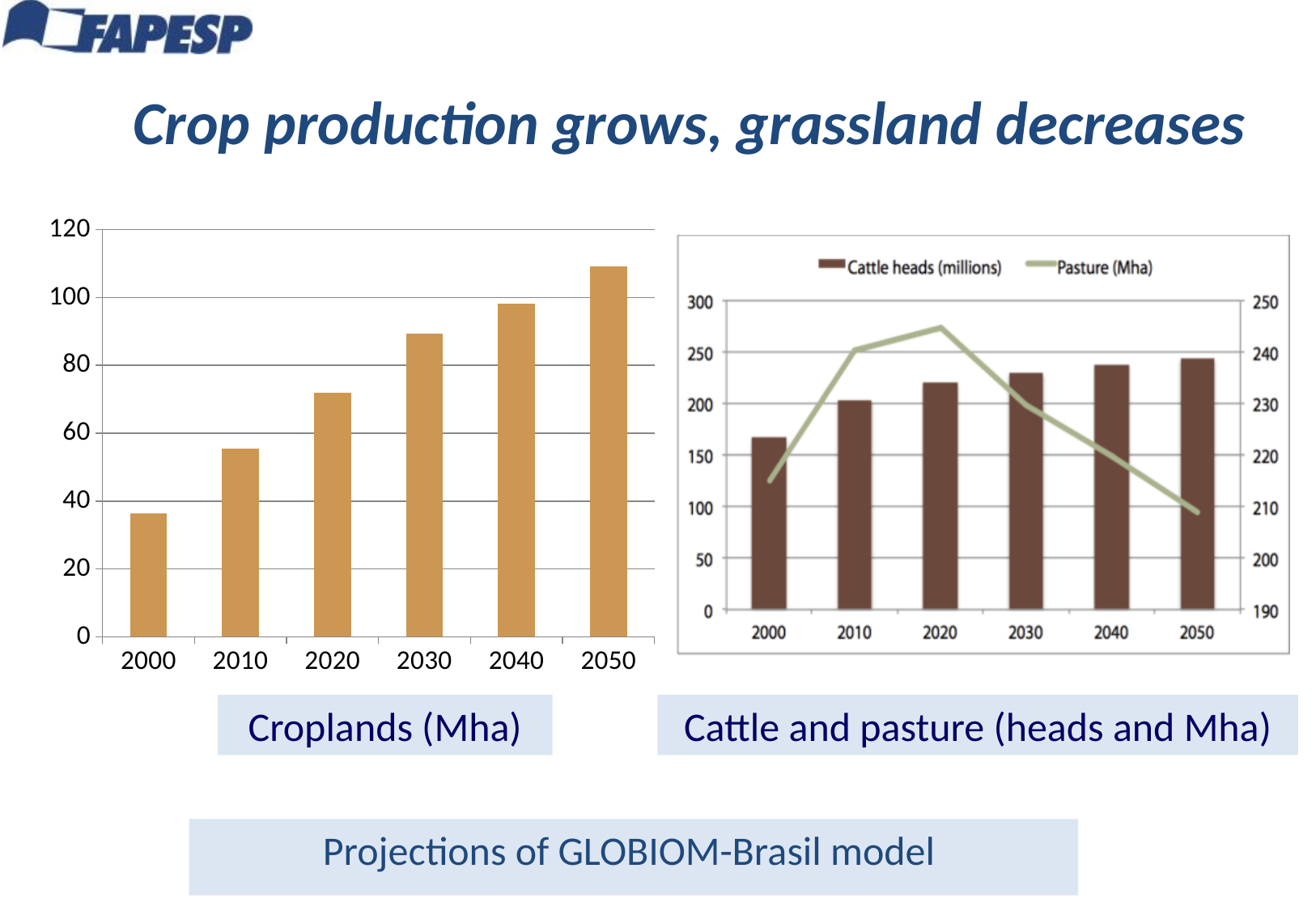
On the Croplands (Mha) chart, is the value for 2000 greater or less than 40? less On the Croplands (Mha) chart, do the values rise or fall from 2000 to 2050? rise On the Croplands (Mha) chart, which year has the lowest value? 2000 On the Croplands (Mha) chart, how many years are shown on the x axis? 6 On the Croplands (Mha) chart, is the value for 2050 greater or less than 100? greater On the Cattle and pasture chart, how many series does the legend list? 2 On the Cattle and pasture chart, is the Cattle heads (millions) value for 2000 greater or less than 200? less On the Cattle and pasture chart, in which year is Pasture (Mha) highest? 2020 On the Cattle and pasture chart, in which year is Cattle heads (millions) lowest? 2000 What kind of chart is the Croplands (Mha) chart? bar chart On the Croplands (Mha) chart, which year has the highest value? 2050